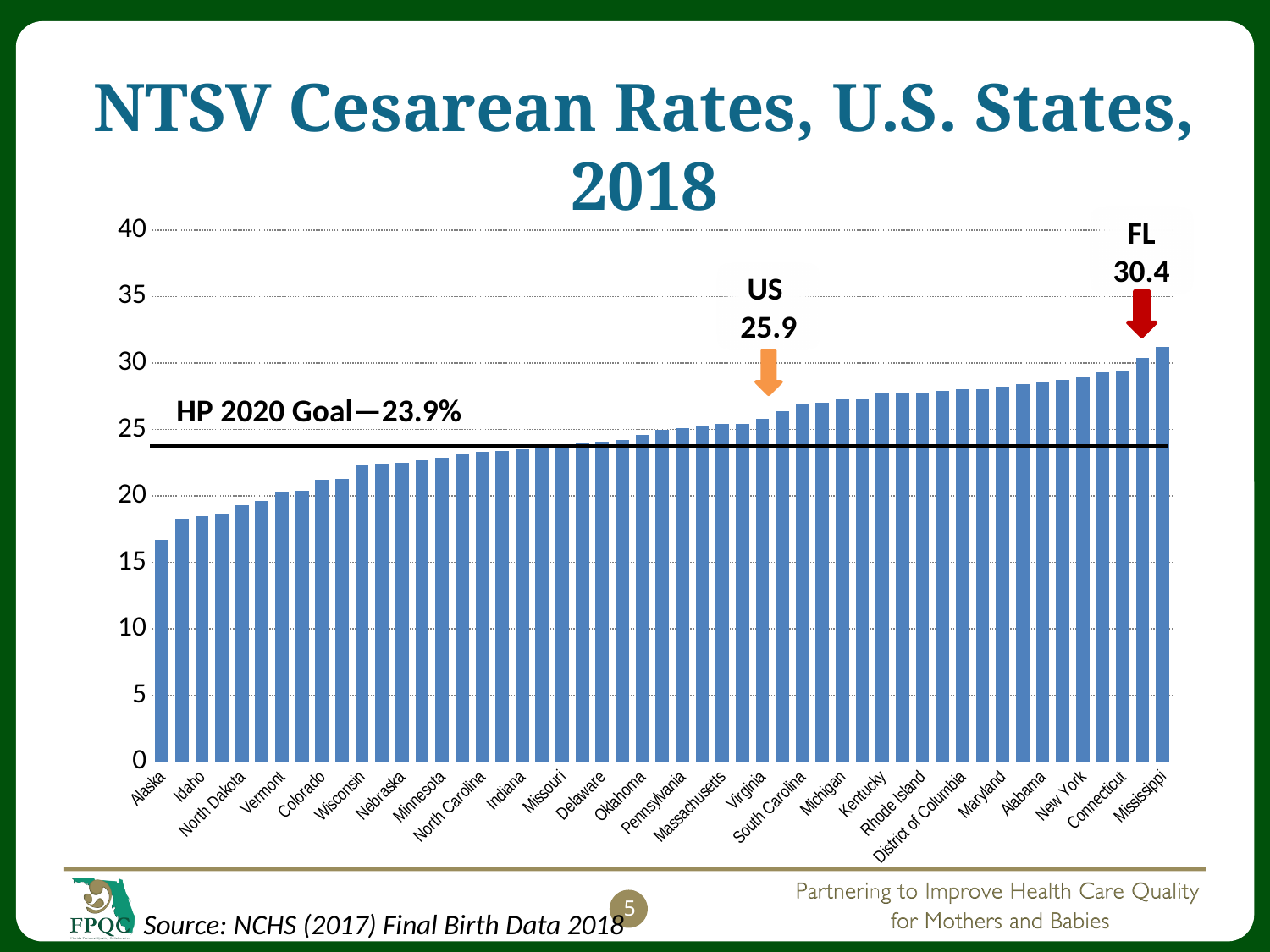
What is the NTSV cesarean rate labeled for FL (Florida) on the chart? 30.4 Which state has the highest NTSV cesarean rate in the chart? Mississippi What kind of chart is shown on the slide? bar chart Which has a higher NTSV cesarean rate, Idaho or New York? New York What is the US NTSV cesarean rate labeled on the chart? 25.9 Is the value for Mississippi greater or less than 30? greater What does the black horizontal line across the chart represent? HP 2020 Goal—23.9% Do the bar values rise or fall moving from left to right along the x axis? rise Which state has the lowest NTSV cesarean rate in the chart? Alaska Is the value for Alaska greater or less than 20? less What is the HP 2020 Goal value shown on the chart? 23.9% How much higher is the FL rate (30.4) than the US rate (25.9)? 4.5